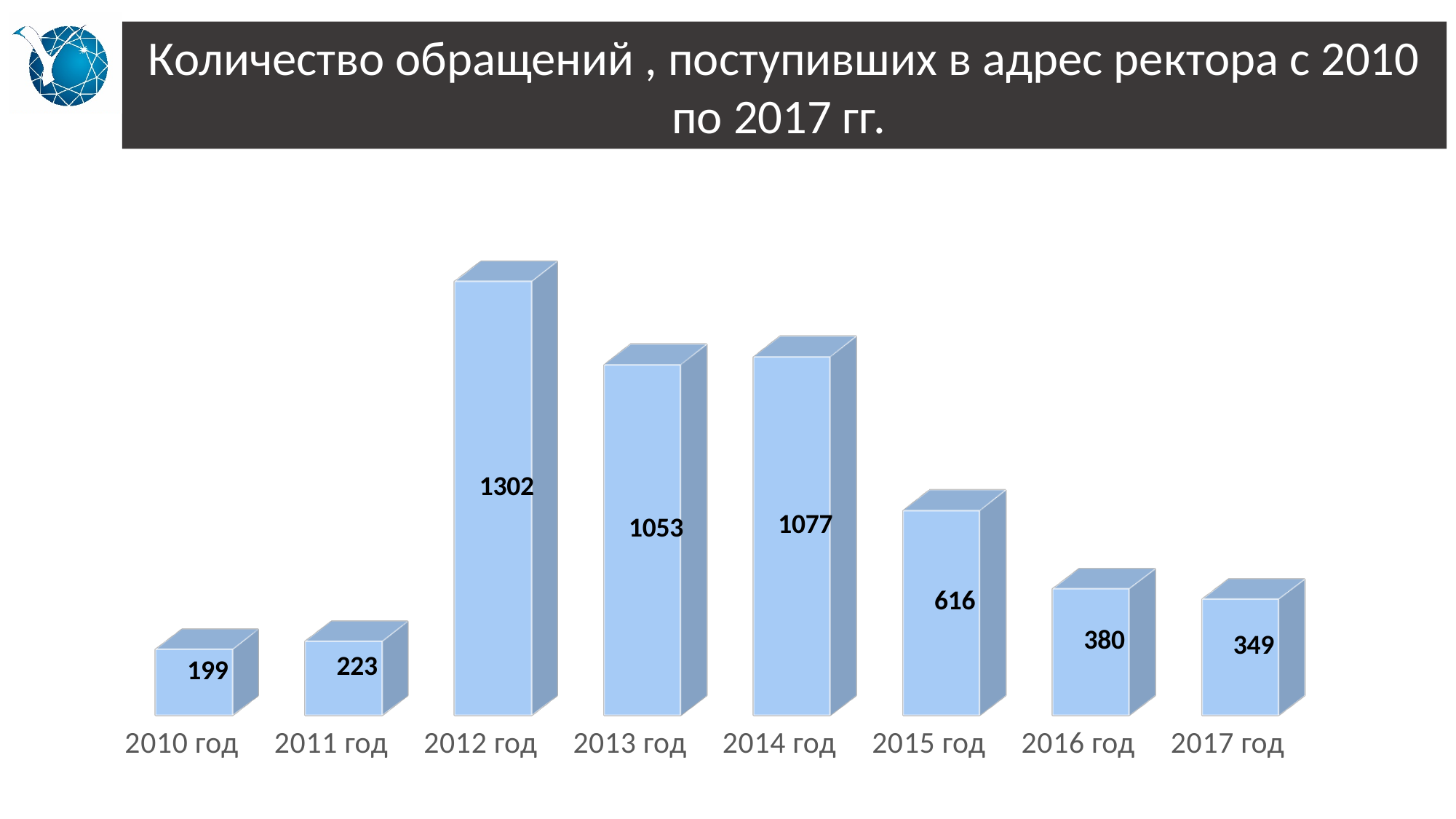
What is the value for 2017 год? 349 Which year has the lowest value? 2010 год What kind of chart is shown on the slide? bar chart What is the title of the chart? Количество обращений , поступивших в адрес ректора с 2010 по 2017 гг. Which year has the highest value? 2012 год How many years are shown on the chart? 8 Do the values rise or fall from 2014 год to 2017 год? fall What is the value for 2012 год? 1302 What is the difference between the values for 2012 год and 2013 год? 249 What is the difference between the values for 2016 год and 2017 год? 31 What is the value for 2015 год? 616 Which is larger, the value for 2013 год or the value for 2014 год? 2014 год